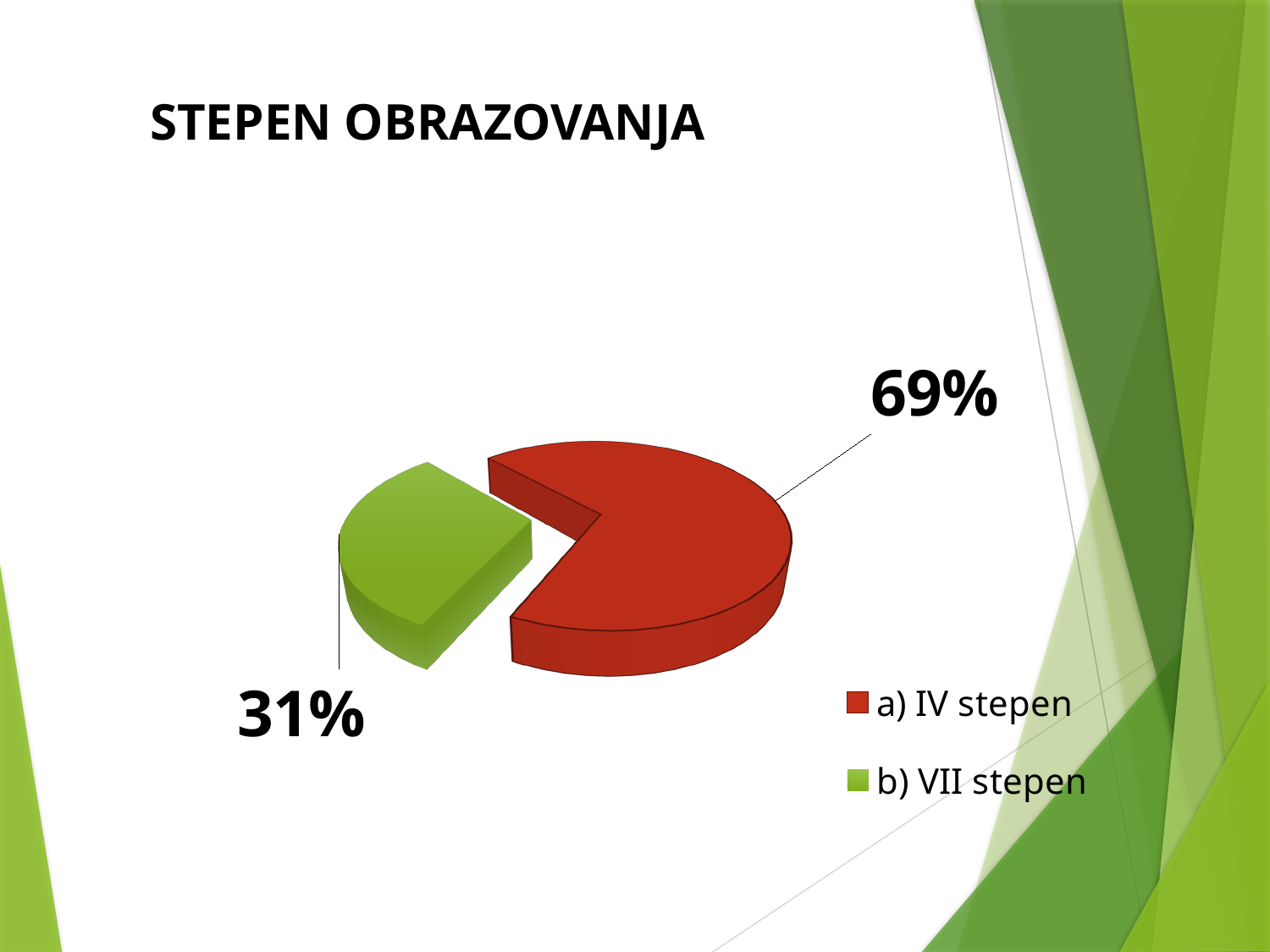
What is the title of the chart? STEPEN OBRAZOVANJA What percentage of the pie is labelled for a) IV stepen? 69% What colour is the slice for b) VII stepen? green What kind of chart is shown on the slide? pie chart How many slices does the pie chart have? 2 Which category has the smallest share of the pie? b) VII stepen Which is larger, the share for a) IV stepen or the share for b) VII stepen? a) IV stepen What share of the pie does a) IV stepen take? 69% What percentage of the pie is labelled for b) VII stepen? 31% How many entries does the legend list? 2 What is the difference in percentage points between a) IV stepen and b) VII stepen? 38 Which category has the largest share of the pie? a) IV stepen